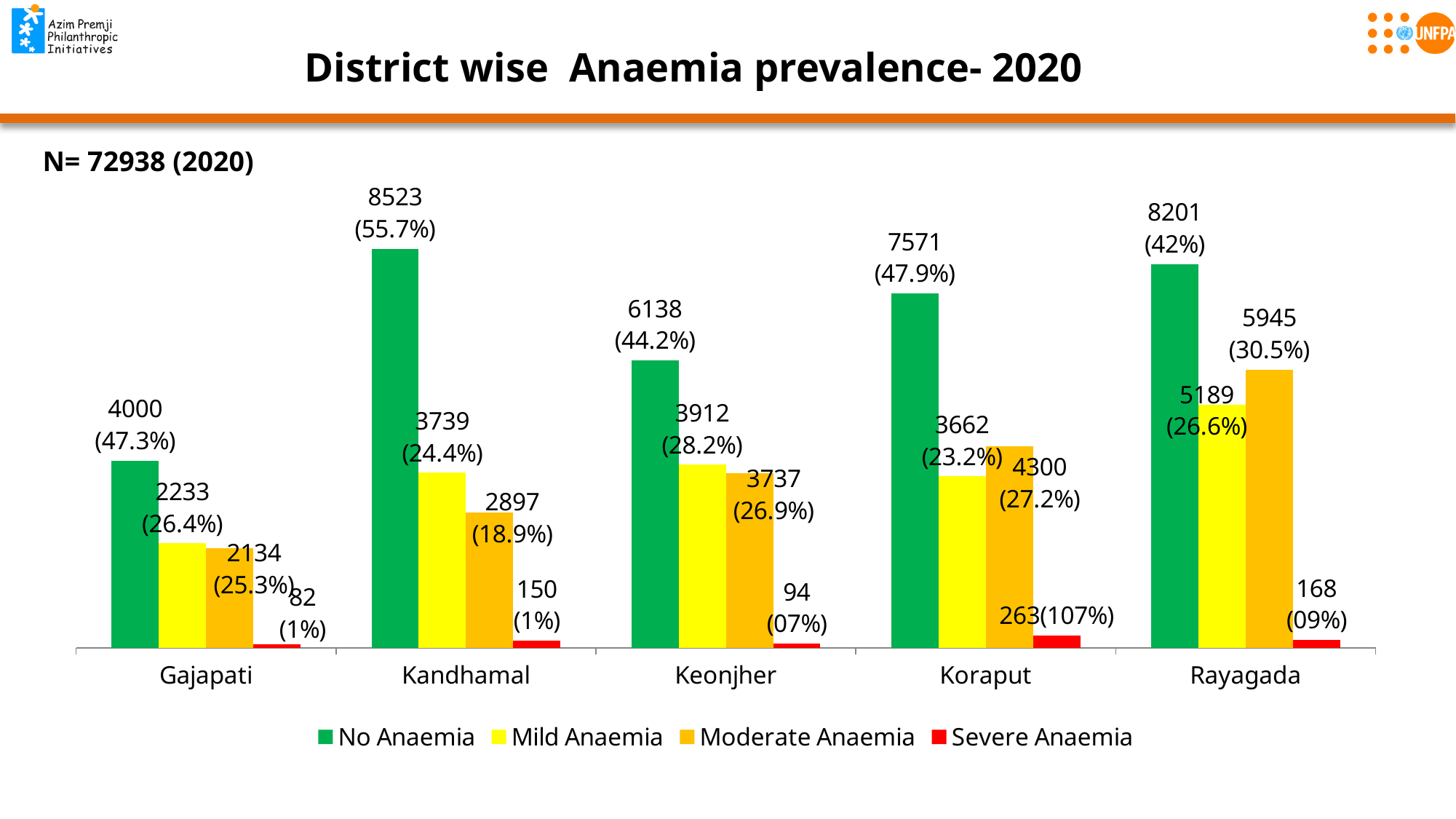
Which is larger, the Mild Anaemia value for Rayagada or the Mild Anaemia value for Kandhamal? Rayagada What is the Moderate Anaemia value for Rayagada? 5945 What is the Severe Anaemia value for Koraput? 263 What is the No Anaemia value for Kandhamal? 8523 What is the title of the chart? District wise Anaemia prevalence- 2020 How many districts are shown on the x axis? 5 Which district has the highest No Anaemia value? Kandhamal What is the difference between the No Anaemia values for Kandhamal and Gajapati? 4523 What is the Mild Anaemia value for Keonjher? 3912 What kind of chart is shown on the slide? Bar chart Which district has the lowest Severe Anaemia value? Gajapati How many series does the legend list? 4